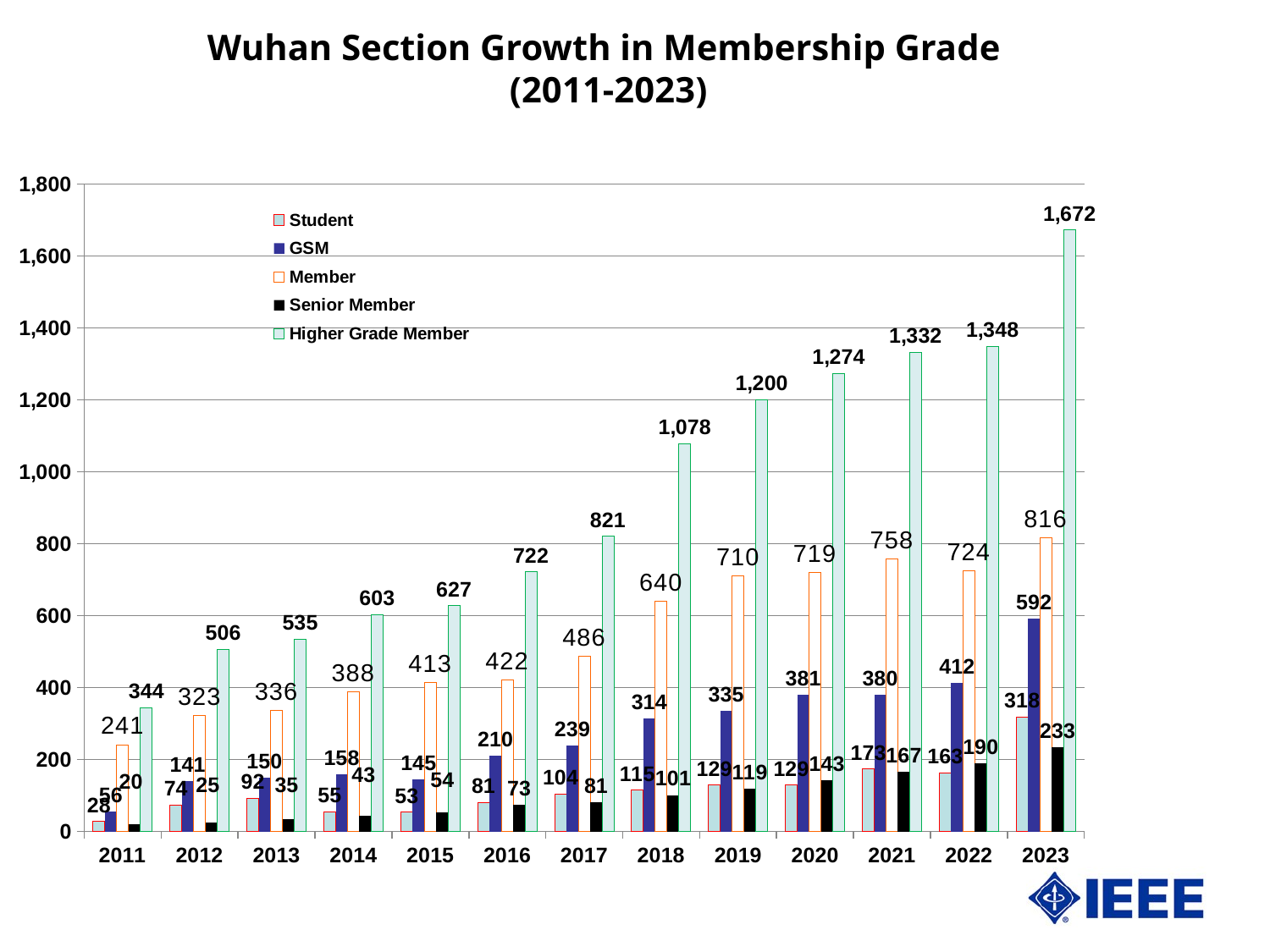
Which year has the larger Member value, 2021 or 2022? 2021 What is the value for Member in 2019? 710 What is the value for Higher Grade Member in 2023? 1,672 What is the title of the chart? Wuhan Section Growth in Membership Grade (2011-2023) How many years are shown on the x axis? 13 How many series does the legend list? 5 What is the value for Senior Member in 2020? 143 What kind of chart is shown on the slide? Bar chart What is the difference between the Higher Grade Member values for 2023 and 2022? 324 In which year is the Student value lowest? 2011 Do the Higher Grade Member values rise or fall from 2011 to 2023? Rise In which year is the Higher Grade Member value highest? 2023